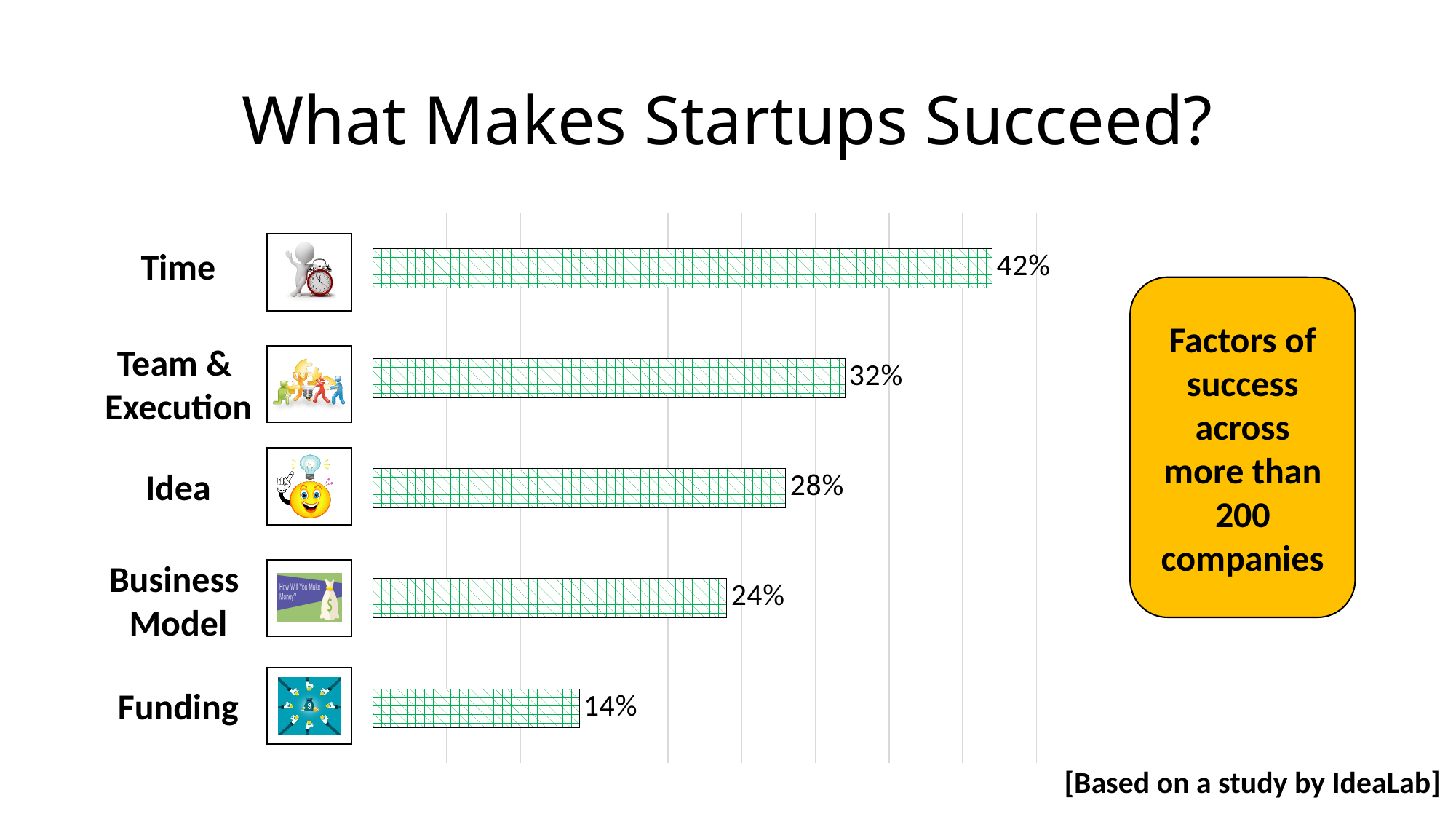
What is the value for Funding? 14% What is the value for Business Model? 24% What is the value for Idea? 28% What kind of chart is shown on the slide? Bar chart Which is larger, the value for Idea or the value for Business Model? Idea Which factor has the highest value? Time What is the value for Time? 42% Which factor has the lowest value? Funding What is the difference between the values for Team & Execution and Idea? 4% How many factors are shown in the chart? 5 What is the value for Team & Execution? 32% What is the difference between the values for Time and Funding? 28%